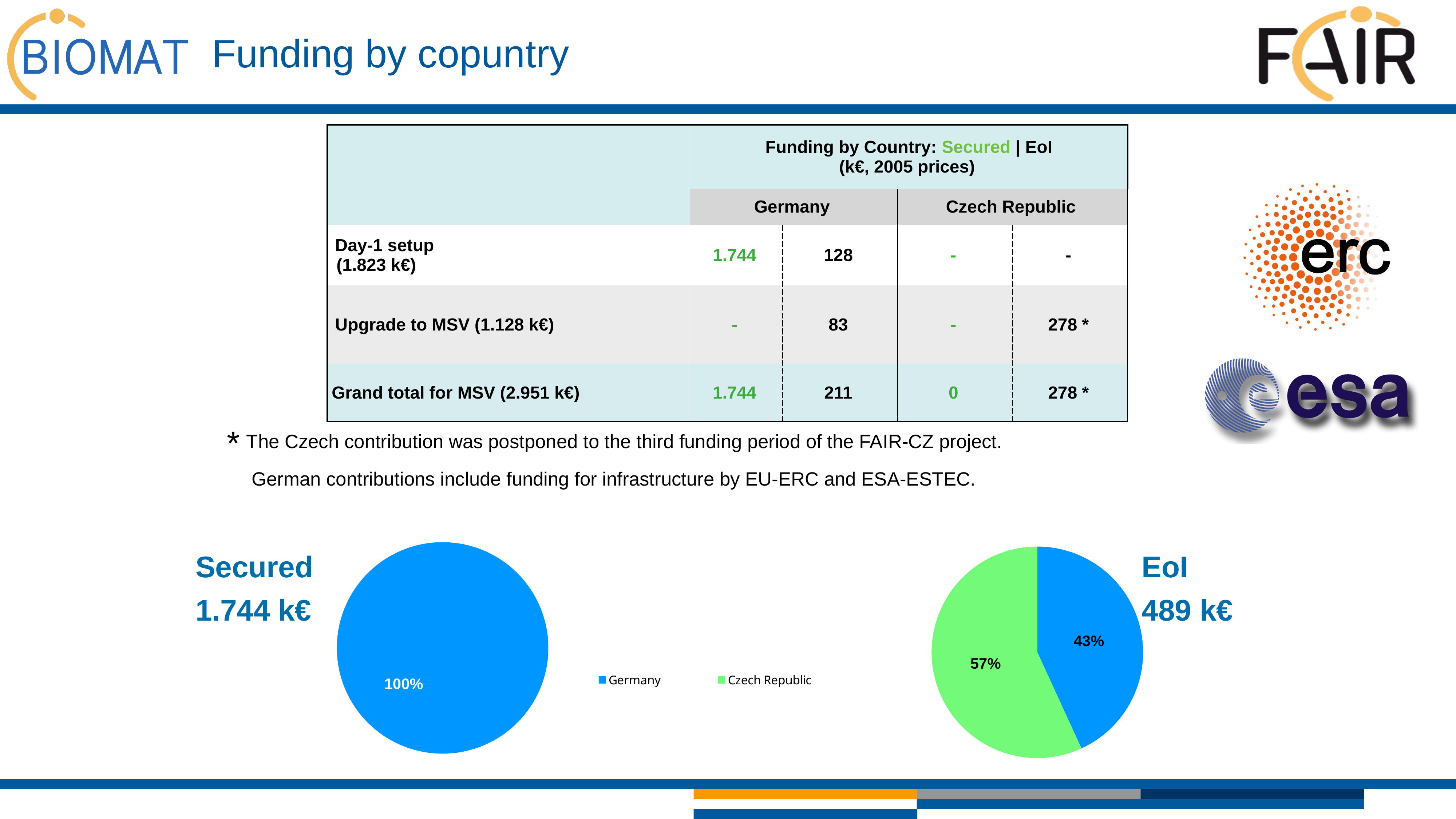
In the EoI pie chart, which country has the larger share? Czech Republic What kind of charts are shown at the bottom of the slide? Pie charts In the EoI pie chart, is the Germany share larger or smaller than the Czech Republic share? Smaller In the EoI pie chart, what share does Germany have? 43% In the EoI pie chart, what is the difference in percentage points between the Czech Republic and Germany shares? 14 percentage points How many slices does the EoI pie chart have? 2 What total amount is shown next to the Secured pie chart? 1.744 k€ What colour represents the Czech Republic in the pie charts? Green In the Secured pie chart, what share does Germany have? 100% In the EoI pie chart, which country has the smaller share? Germany In the EoI pie chart, what share does the Czech Republic have? 57% How many entries does the legend between the two pie charts list? 2